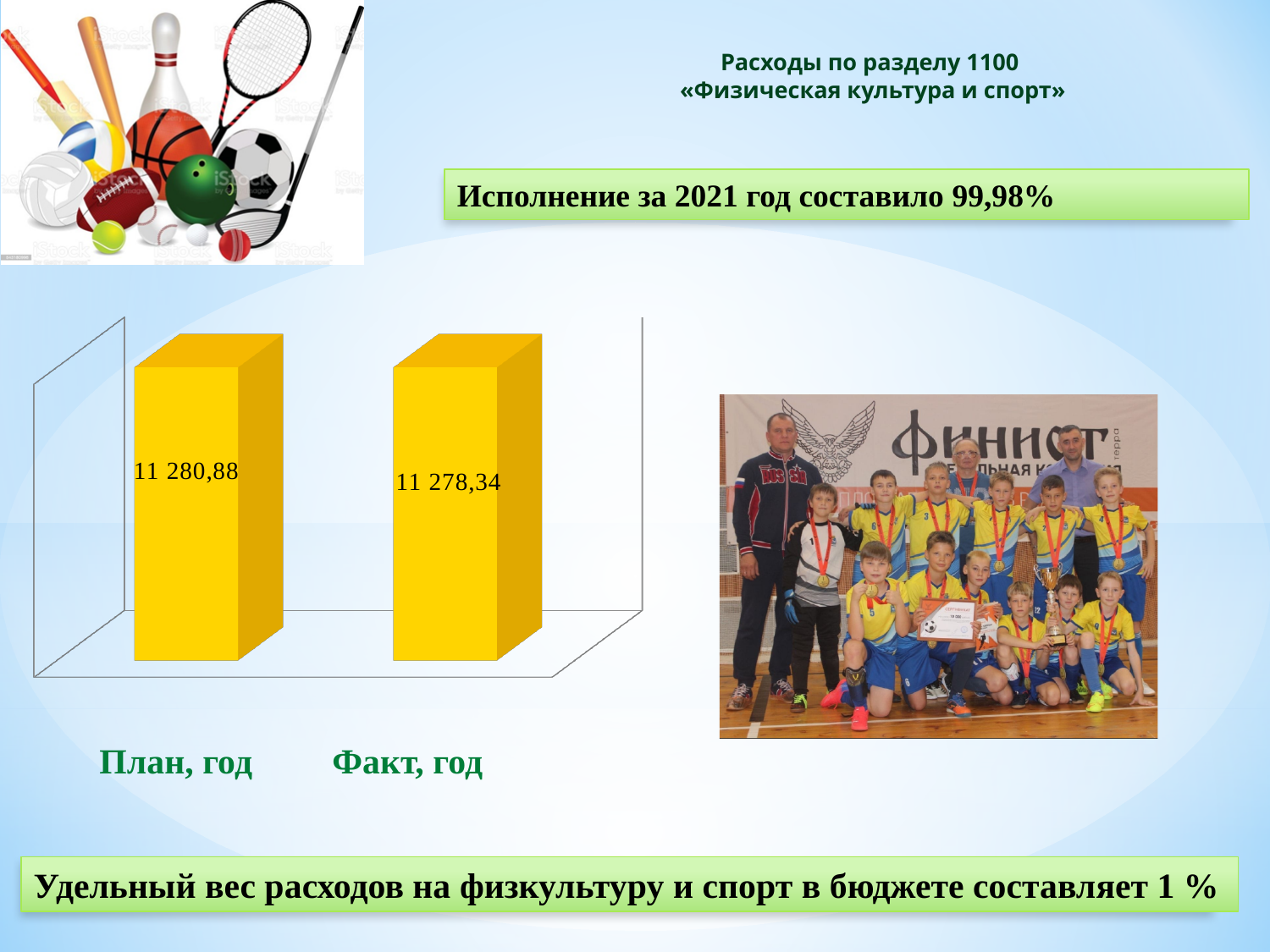
What colour are the bars in the chart? yellow What is the difference between the values for План, год and Факт, год? 2,54 Which category has the lowest value? Факт, год Which category has the higher value, План, год or Факт, год? План, год What is the value for План, год? 11 280,88 How many bars are shown in the chart? 2 What are the category labels under the bars? План, год and Факт, год What kind of chart is shown on the slide? bar chart What is the value for Факт, год? 11 278,34